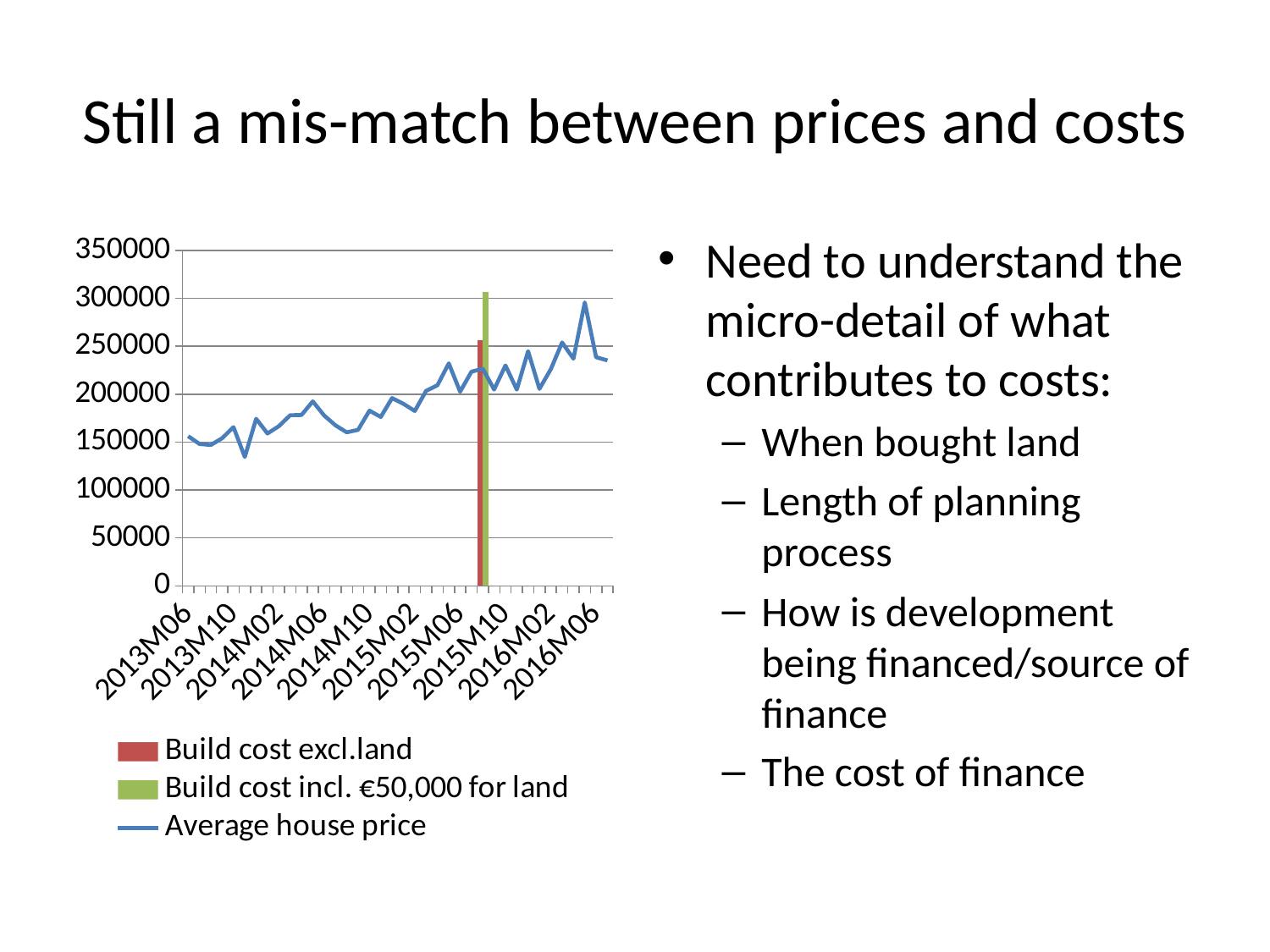
Is the value of the 'Build cost excl.land' bar greater or less than 200000? greater Is the Average house price at 2013M06 greater or less than 200000? less What colour is the bar for 'Build cost incl. €50,000 for land'? Green What is the maximum value shown on the vertical axis? 350000 Does the Average house price line generally rise or fall from 2013M06 to 2016M06? Rise Which bar is taller: 'Build cost excl.land' or 'Build cost incl. €50,000 for land'? Build cost incl. €50,000 for land What kind of chart is shown on the slide? A combined line and bar chart Is the value of the 'Build cost incl. €50,000 for land' bar greater or less than 300000? greater Which series is drawn as a line in the chart? Average house price How many series does the chart legend list? 3